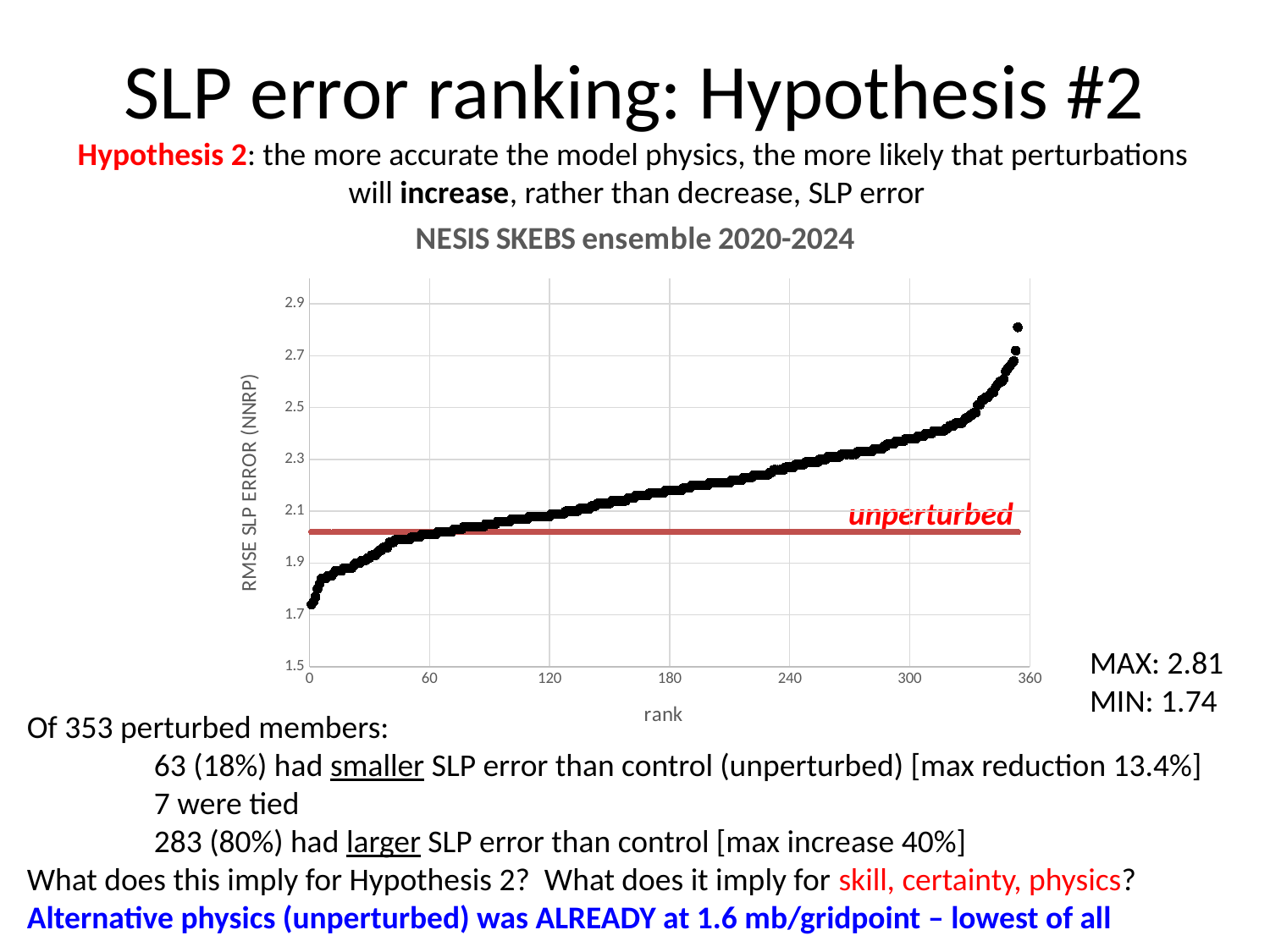
Is the RMSE SLP error value at rank 300 greater or less than 2.1? greater Which is larger: the RMSE SLP error at rank 60 or at rank 240? rank 240 What is the minimum RMSE SLP error value among the plotted members? 1.74 What is the maximum RMSE SLP error value among the plotted members? 2.81 What is the title of the chart? NESIS SKEBS ensemble 2020-2024 Is the unperturbed (red line) RMSE SLP error value greater or less than 2.1? less Do the plotted RMSE SLP error values rise or fall as rank increases along the x axis? rise What is the difference between the maximum (2.81) and minimum (1.74) RMSE SLP error values? 1.07 What is the label of the red horizontal line on the chart? unperturbed What kind of chart is shown on the slide? scatter chart How many perturbed members are plotted in the chart? 353 Is the RMSE SLP error value at rank 0 greater or less than 1.9? less